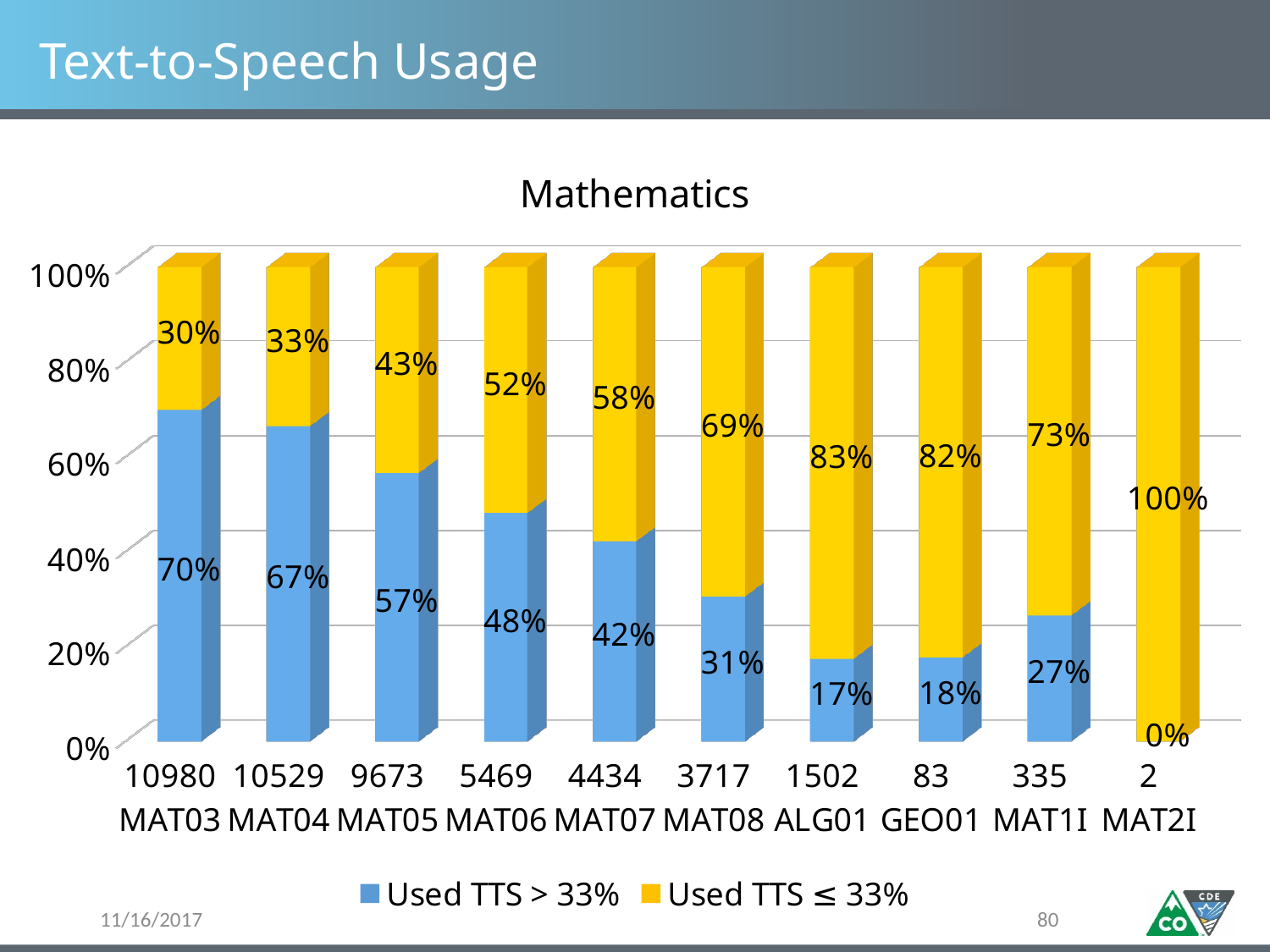
What is the difference between the Used TTS > 33% values for MAT04 and MAT05? 10% What is the total of the stacked bar for MAT08? 100% Which is larger: the Used TTS ≤ 33% value for ALG01 or for MAT1I? ALG01 Which category has the highest share of students who used TTS > 33%? MAT03 What is the title of the chart? Mathematics Which category has the lowest share of students who used TTS > 33%? MAT2I How many series does the legend list? 2 What percentage of GEO01 students used TTS > 33%? 18% What kind of chart is shown on the slide? Stacked bar chart What percentage of MAT03 students used TTS > 33%? 70% What percentage of MAT07 students used TTS ≤ 33%? 58% How many categories are shown on the x axis? 10